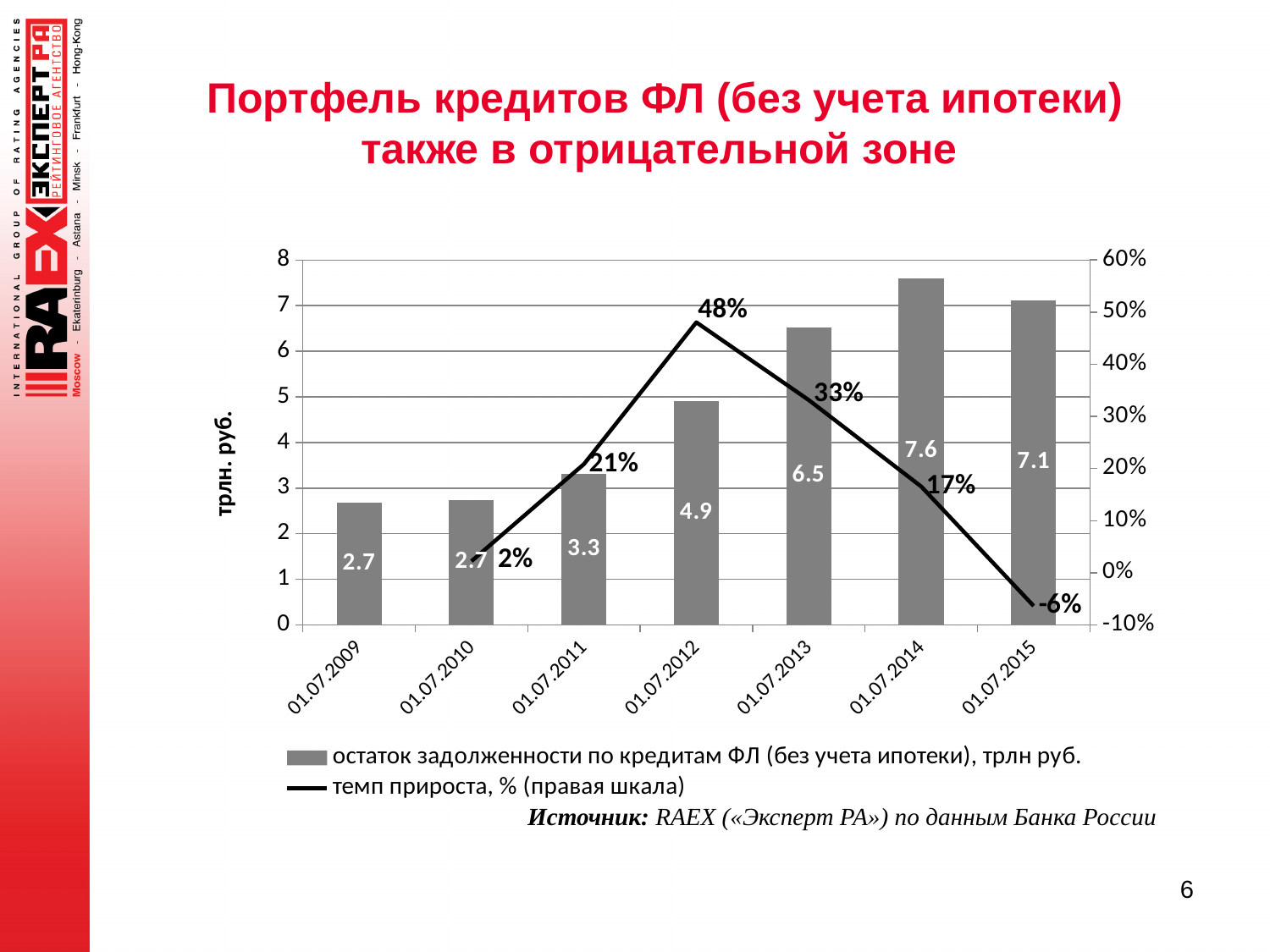
What is the difference between the bar values for 01.07.2014 and 01.07.2015? 0.5 What is the label of the left vertical axis? трлн. руб. How many dates are shown on the x axis? 7 What kind of chart is this? Combined bar and line chart Which date has the highest bar value? 01.07.2014 How many series does the legend list? 2 Which date has the lowest growth rate on the line? 01.07.2015 What is the growth rate (темп прироста) shown for 01.07.2015? -6% What is the growth rate (темп прироста) shown for 01.07.2012? 48% What is the value of the bar for 01.07.2013? 6.5 Does the growth rate line rise or fall from 01.07.2012 to 01.07.2015? Fall Which is larger: the bar value for 01.07.2012 or for 01.07.2013? 01.07.2013